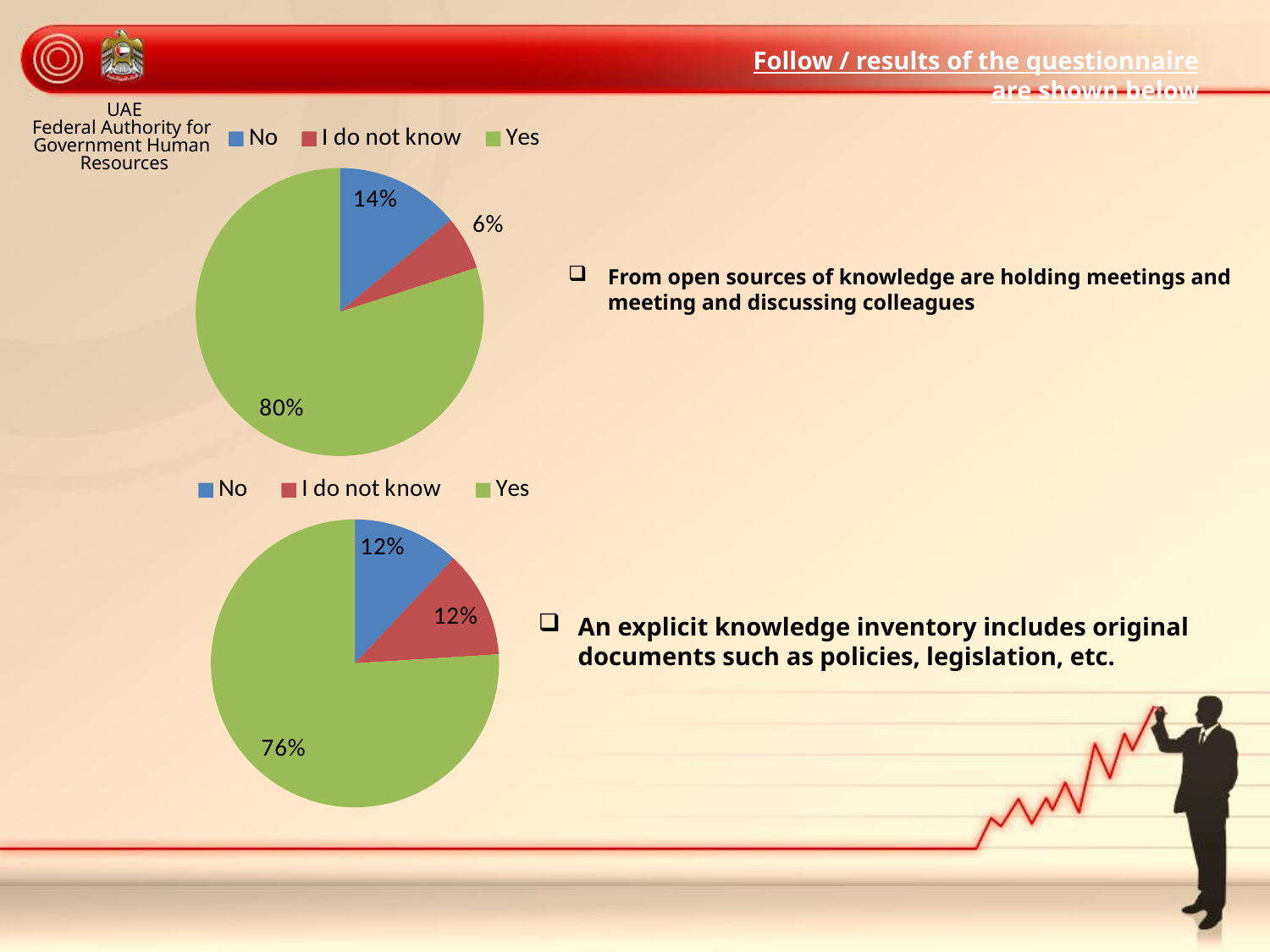
In the top pie chart, which category has the smallest slice? I do not know In the bottom pie chart, what share is labelled for Yes? 76% In the bottom pie chart, what share is labelled for I do not know? 12% In the top pie chart, what share is labelled for I do not know? 6% In the bottom pie chart, what is the difference between the Yes share and the No share? 64% In the bottom pie chart, which category has the largest slice? Yes In the top pie chart, what share is labelled for Yes? 80% In the top pie chart, what is the difference between the No share and the I do not know share? 8% What type of chart is the bottom chart? Pie chart In the top pie chart, which category has the largest slice? Yes How many categories does the legend of the top pie chart list? 3 In the top pie chart, what share is labelled for No? 14%